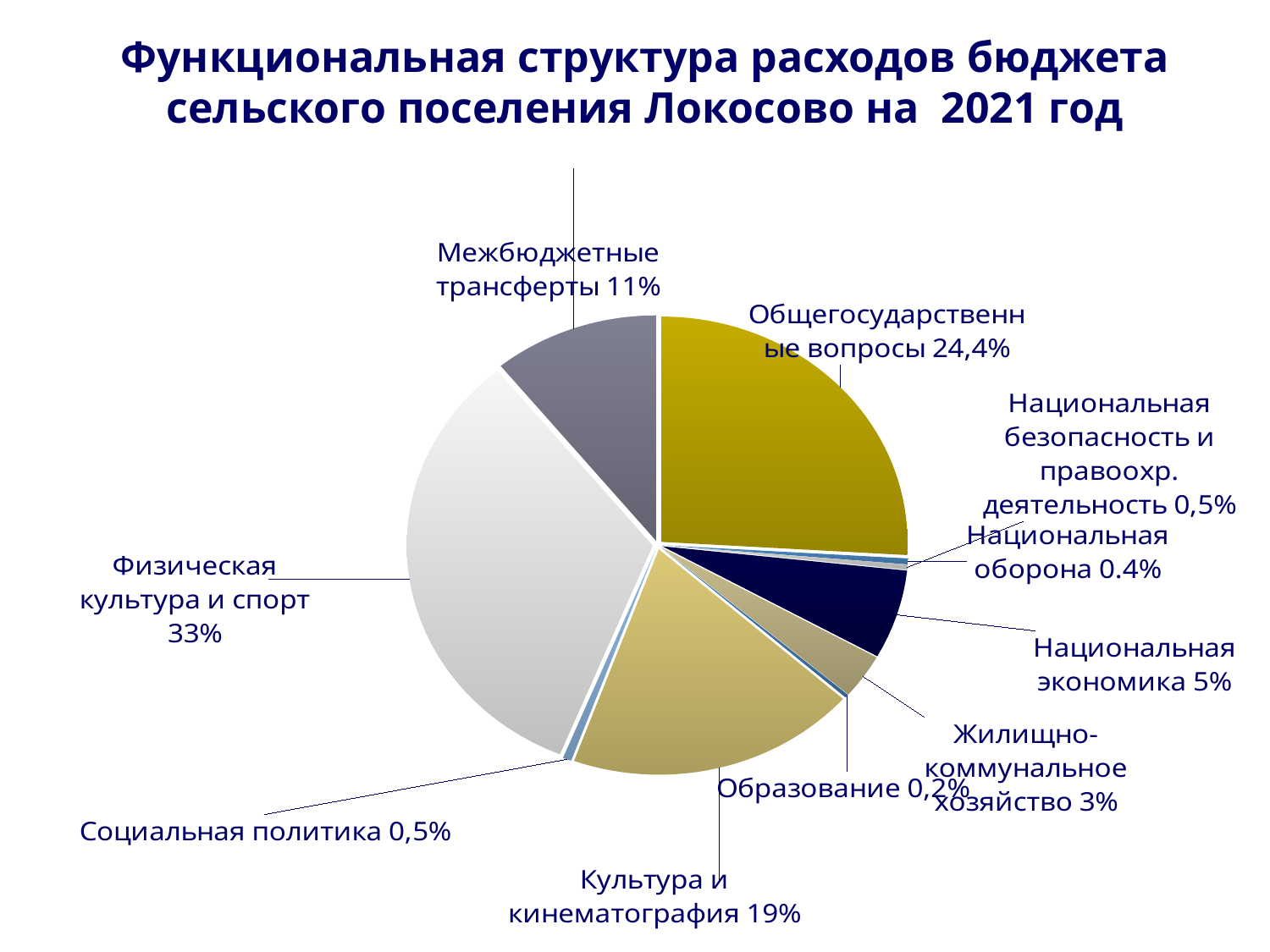
What share is shown for Межбюджетные трансферты? 11% What share is shown for Национальная экономика? 5% What share of the budget expenditure is Физическая культура и спорт? 33% What share is shown for Культура и кинематография? 19% What share is shown for Общегосударственные вопросы? 24,4% Which category has the largest share of the pie? Физическая культура и спорт What share is shown for Образование? 0,2% Which is larger, Культура и кинематография or Межбюджетные трансферты? Культура и кинематография How many categories (slices) does the pie chart have? 10 Which category has the smallest share of the pie? Образование What kind of chart is shown on the slide? pie chart What is the difference between the shares of Физическая культура и спорт and Культура и кинематография? 14%